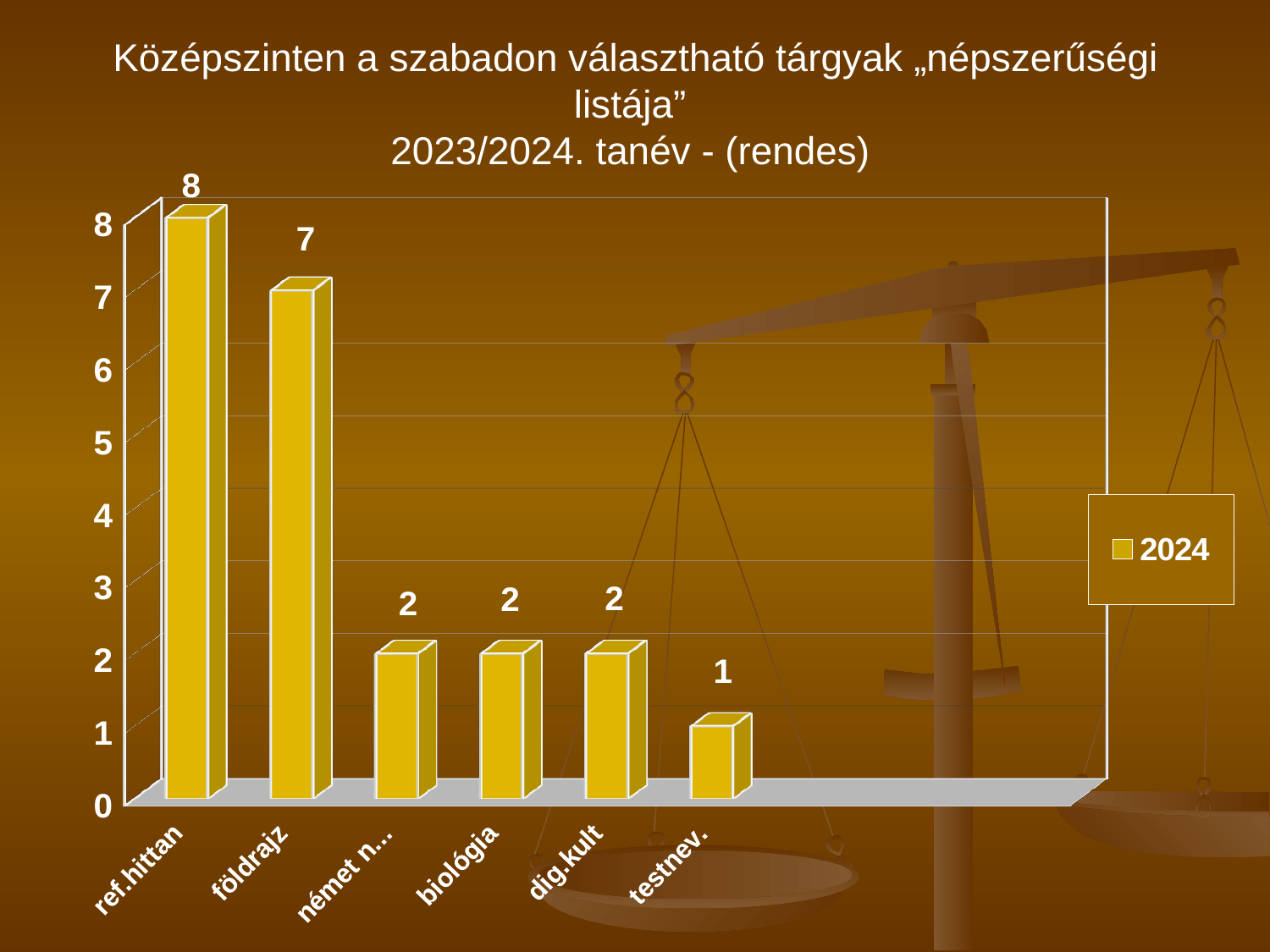
Which category has the lowest value? testnev. What is the value for testnev.? 1 What is the value for biológia? 2 How many series does the legend list? 1 What kind of chart is shown on the slide? bar chart What is the difference between the values for ref.hittan and földrajz? 1 How many categories are shown on the x axis? 6 What is the value for ref.hittan? 8 What is the difference between the values for földrajz and dig.kult? 5 Which category has the highest value? ref.hittan What is the value for földrajz? 7 Which is larger, the value for dig.kult or the value for testnev.? dig.kult